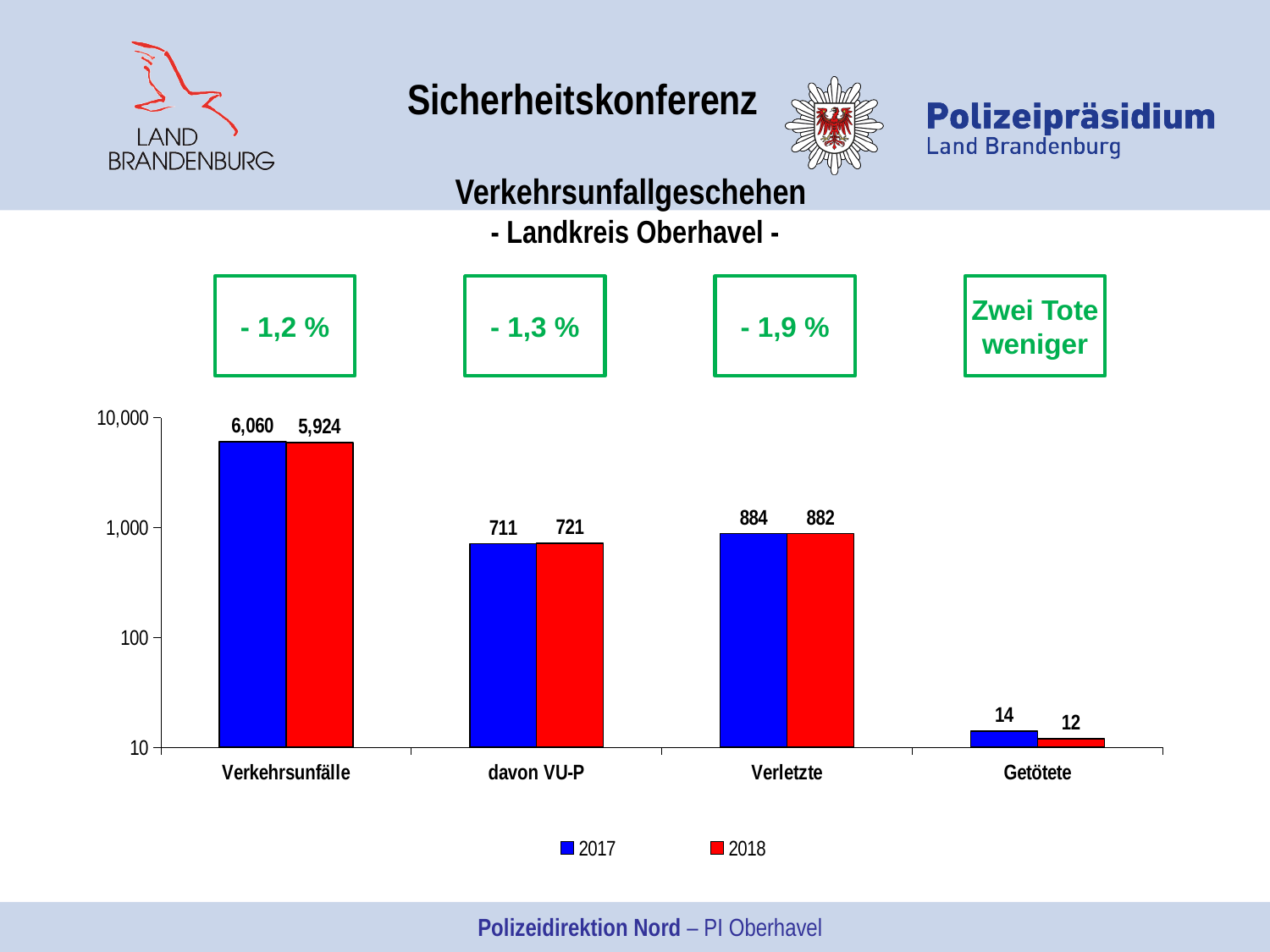
What is the difference between the 2017 and 2018 values for Getötete? 2 What is the value for Verkehrsunfälle in 2017? 6,060 Which category has the lowest value in 2017? Getötete What is the value for davon VU-P in 2018? 721 What kind of chart is shown on the slide? Bar chart What is the value for Getötete in 2017? 14 Which is larger for davon VU-P: the 2017 value or the 2018 value? 2018 Which category has the highest value in 2018? Verkehrsunfälle What is the value for Verkehrsunfälle in 2018? 5,924 What is the difference between the 2017 and 2018 values for Verkehrsunfälle? 136 How many series does the legend list? 2 How many categories are shown on the x axis? 4